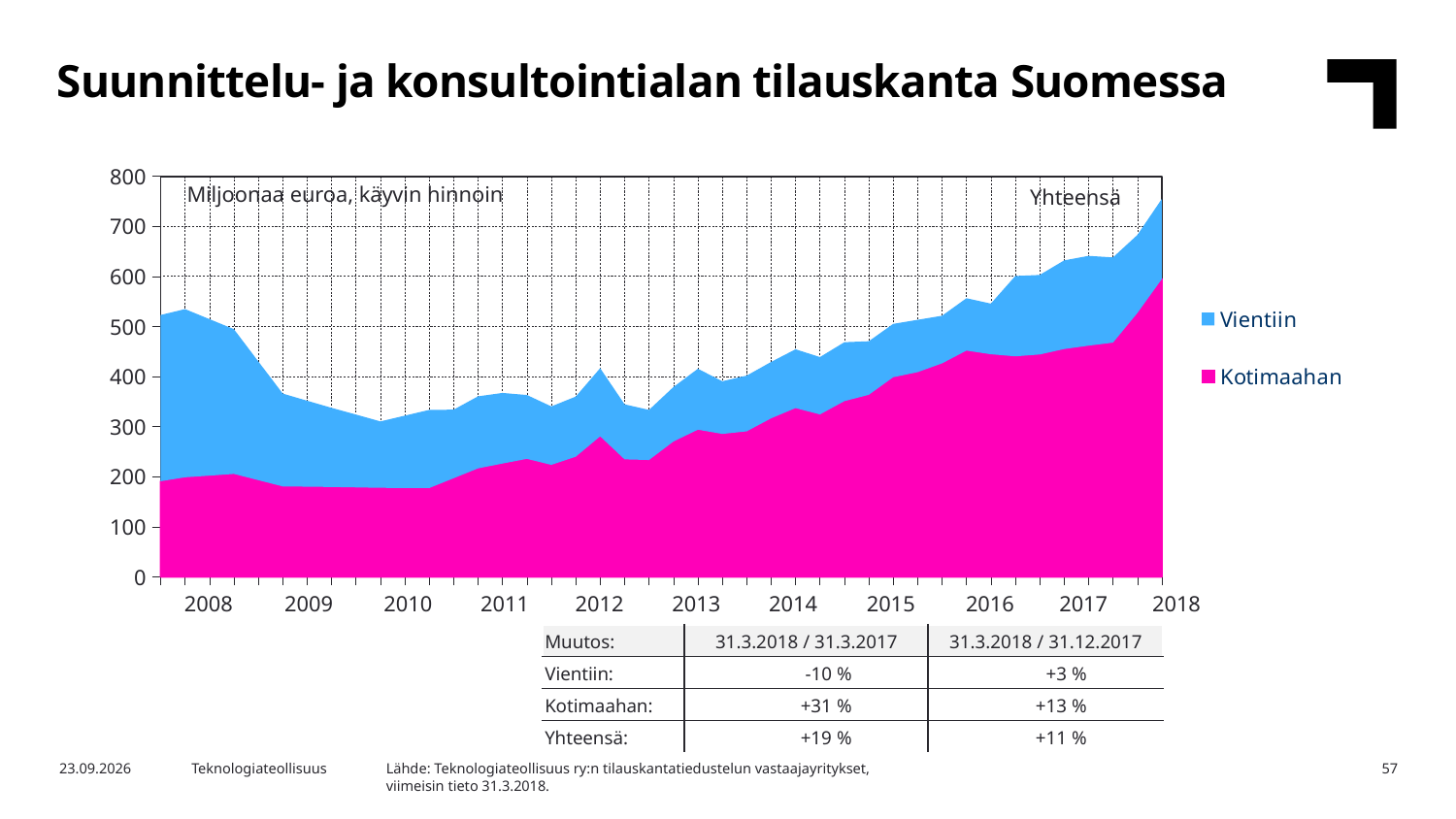
Is the total (Yhteensä) value around 2010 greater or less than 400? less Does the total (Yhteensä) value rise or fall between 2008 and 2010? fall Is the total (Yhteensä) value at the end of the chart (2018) greater or less than 700? greater How many series does the chart legend list? 2 What kind of chart is shown on the slide? Stacked area chart Is the total (Yhteensä) value larger at the start of 2008 or at the end of the chart in 2018? 2018 What are the two series named in the chart legend? Vientiin and Kotimaahan Is the Kotimaahan value around 2010 greater or less than 200? less What unit is stated in the chart's subtitle? Miljoonaa euroa, käyvin hinnoin According to the table below the chart, what is the change in Kotimaahan for 31.3.2018 / 31.3.2017? +31 % Does the Kotimaahan value rise or fall between 2013 and 2018? rise